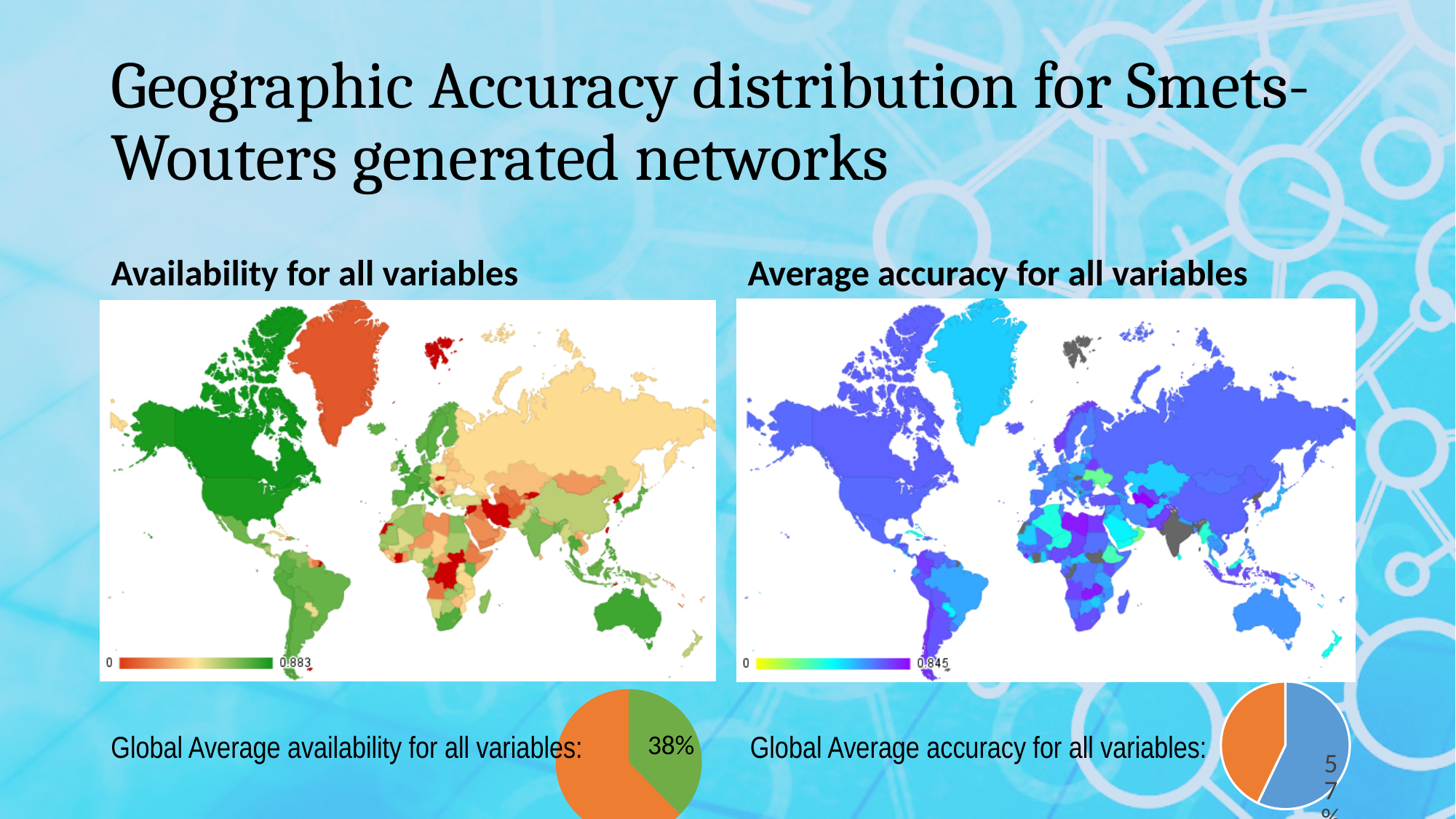
What share of the pie chart for Global Average availability for all variables does the green slice represent? 38% What kind of chart is the small chart next to 'Global Average availability for all variables'? pie chart Which is larger, the global average availability for all variables (38%) or the global average accuracy for all variables (57%)? global average accuracy (57%) In the pie chart for Global Average availability for all variables, which slice is larger, the green one or the orange one? orange On the 'Availability for all variables' map, what is the maximum value shown on the colour scale? 0.883 In the pie chart for Global Average accuracy for all variables, what percentage is shown on the blue slice? 57% What kind of chart is the small chart next to 'Global Average accuracy for all variables'? pie chart On the 'Average accuracy for all variables' map, what is the maximum value shown on the colour scale? 0.845 What is the difference in percentage points between the global average accuracy (57%) and the global average availability (38%) shown in the two pie charts? 19 In the pie chart for Global Average accuracy for all variables, which slice is larger, the blue one or the orange one? blue In the pie chart for Global Average availability for all variables, what percentage is shown on the green slice? 38% How many slices does the pie chart for Global Average availability for all variables have? 2